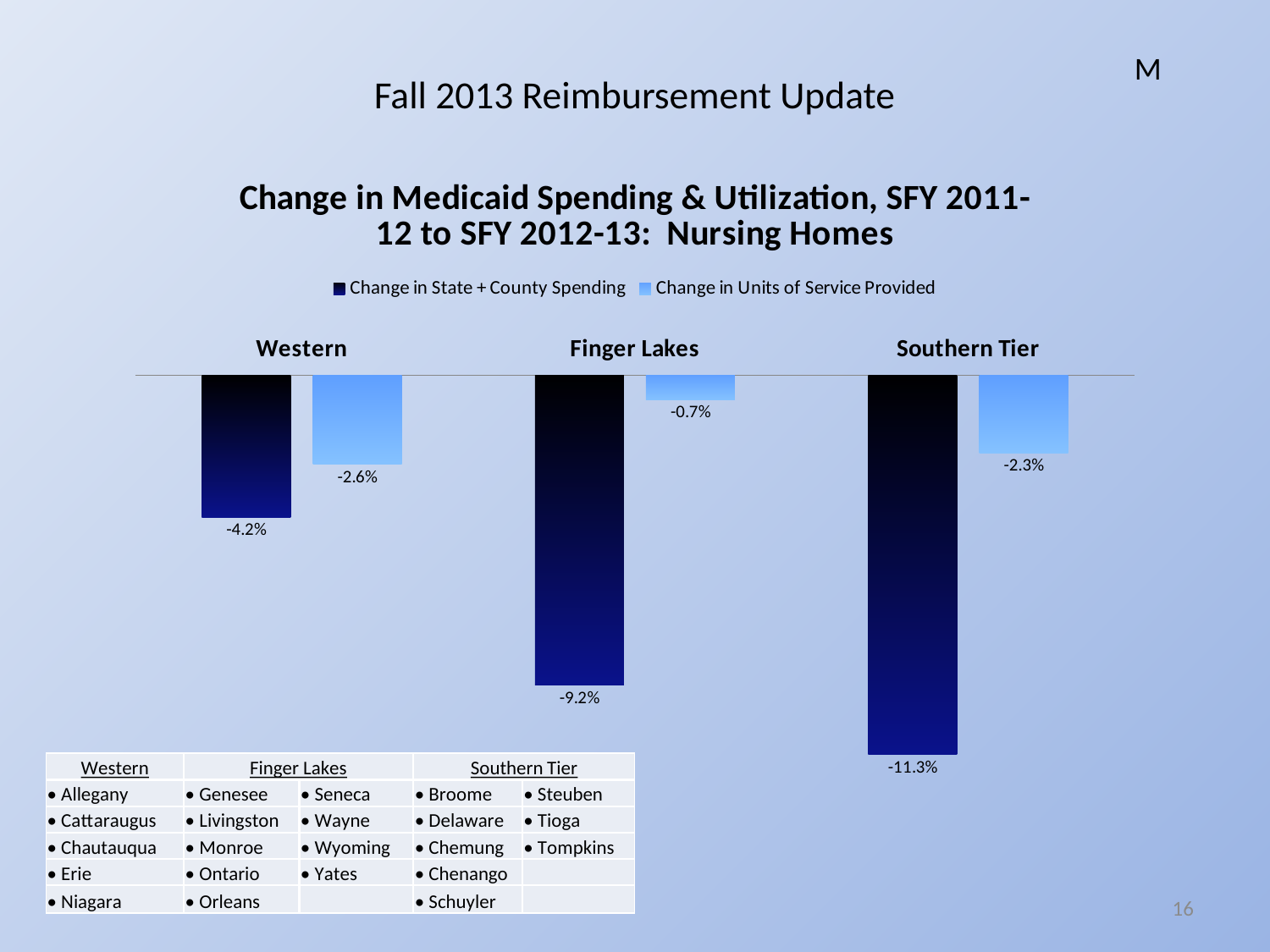
How many regions are shown in the chart? 3 What is the title of the chart? Change in Medicaid Spending & Utilization, SFY 2011-12 to SFY 2012-13: Nursing Homes What is the Change in State + County Spending for Western? -4.2% Which region has the smallest decline in Units of Service Provided? Finger Lakes Which region shows a larger decline in Units of Service Provided, Western or Southern Tier? Western What is the difference between the Change in State + County Spending and the Change in Units of Service Provided for Finger Lakes? 8.5 percentage points What is the Change in Units of Service Provided for Finger Lakes? -0.7% What kind of chart is shown on the slide? Bar chart What is the Change in Units of Service Provided for Southern Tier? -2.3% How many series does the legend list? 2 Which region has the largest decline in State + County Spending? Southern Tier What is the Change in State + County Spending for Southern Tier? -11.3%